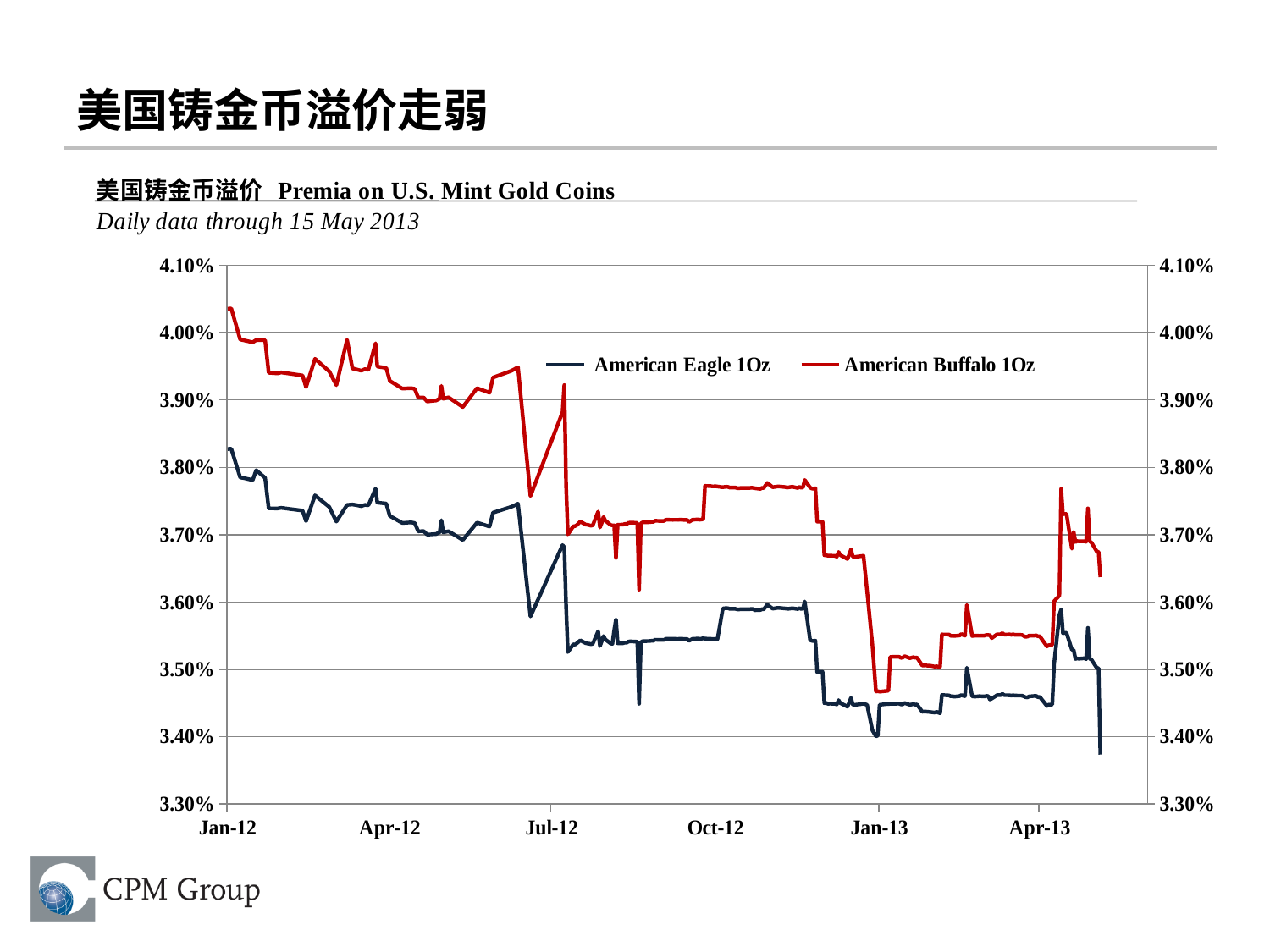
Is the American Buffalo 1Oz premium at Jan-12 greater or less than 4.00%? greater What is the title of the chart? Premia on U.S. Mint Gold Coins Is the American Eagle 1Oz premium at Jan-13 greater or less than 3.50%? less Does the American Buffalo 1Oz premium rise or fall overall from Jan-12 to May 2013? Fall Is the American Buffalo 1Oz premium at Apr-13 greater or less than 3.60%? less Which series reaches the lowest value shown on the chart? American Eagle 1Oz What kind of chart is shown on the slide? Line chart Does the American Eagle 1Oz premium rise or fall overall from Jan-12 to May 2013? Fall How many series does the legend list? 2 Which series has the higher premium throughout the period, American Eagle 1Oz or American Buffalo 1Oz? American Buffalo 1Oz Which series is drawn in red? American Buffalo 1Oz